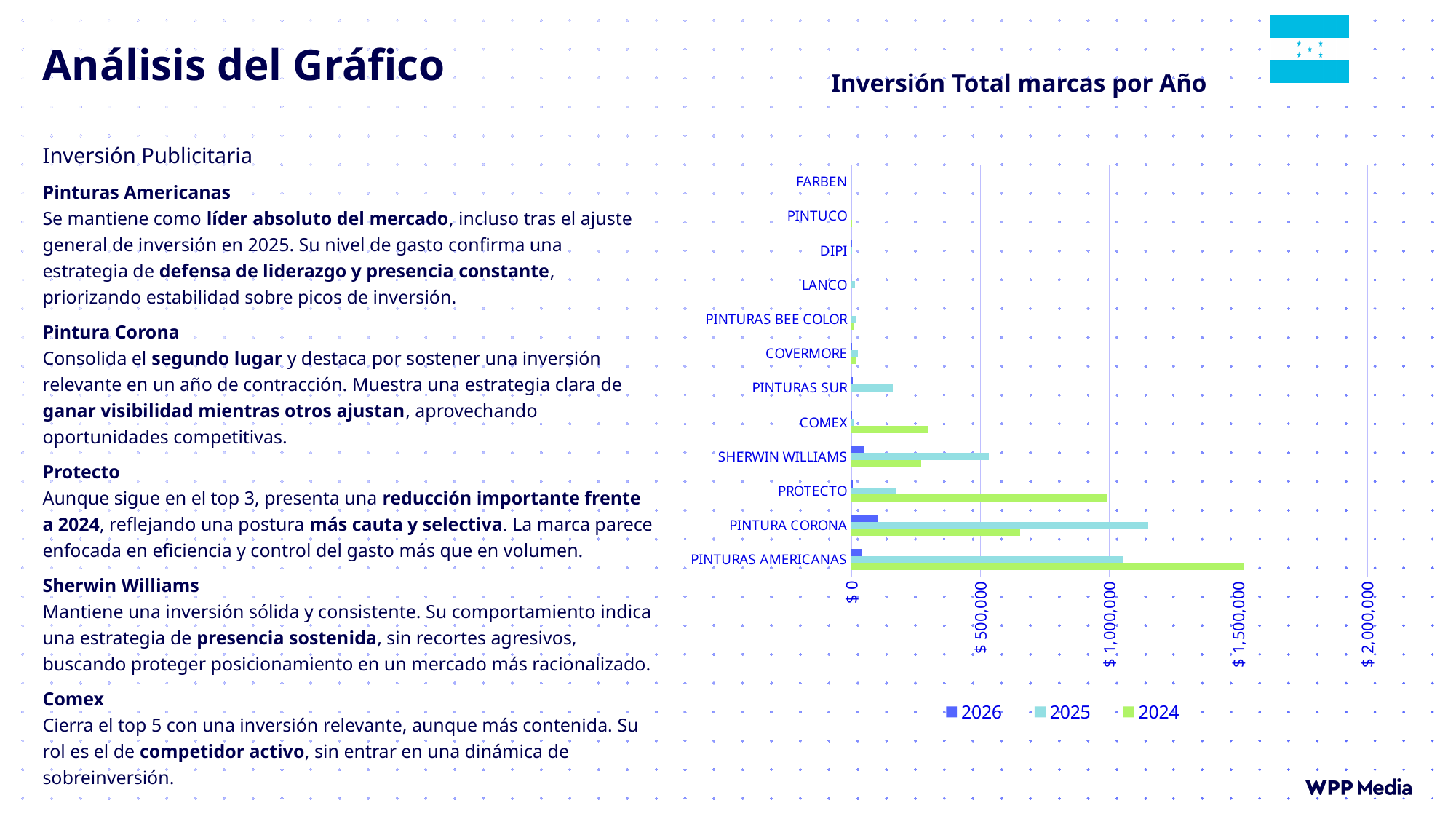
How many brands (categories) are shown on the chart? 12 Which brand has the highest 2025 investment? Pintura Corona Is the 2025 value for Pintura Corona greater or less than $1,000,000? greater Is the 2024 value for Comex greater or less than $500,000? less How many series does the chart legend list? 3 What type of chart is shown on the slide? Bar chart What is the title of the chart? Inversión Total marcas por Año Which years are listed in the chart legend? 2026, 2025, 2024 For Pintura Corona, which is larger: the 2025 value or the 2024 value? 2025 Which brand has the highest 2026 investment? Pintura Corona For Protecto, which is larger: the 2024 value or the 2025 value? 2024 Which brand has the highest 2024 investment? Pinturas Americanas